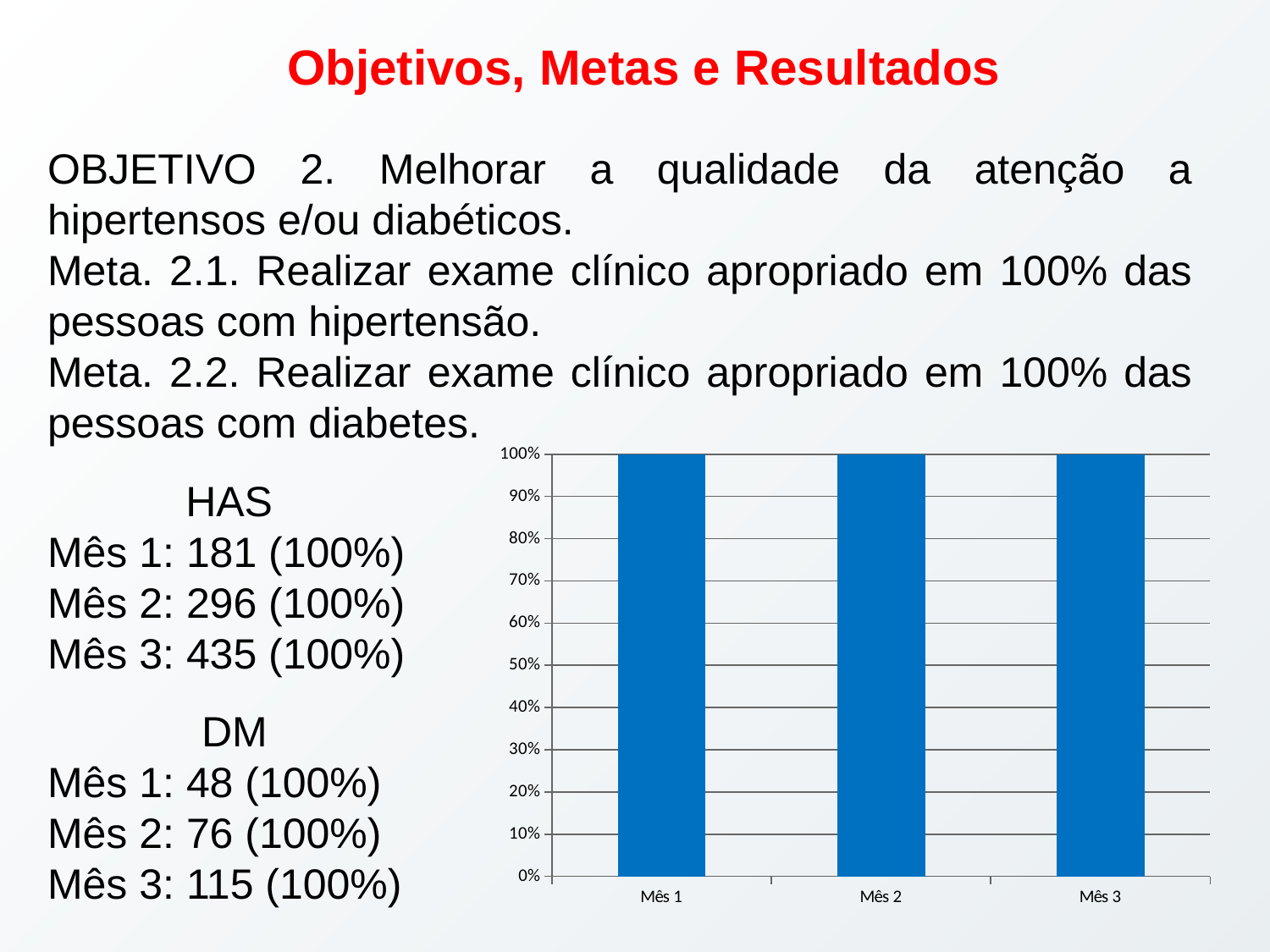
What are the category labels on the x axis of the chart? Mês 1, Mês 2, Mês 3 What value does the bar for Mês 3 reach in the chart? 100% Is the value for Mês 2 greater or less than 50%? greater Do the bar values rise, fall or stay the same from Mês 1 to Mês 3? stay the same Is the value for Mês 3 greater or less than 90%? greater What is the highest value shown on the chart's y axis? 100% What value does the bar for Mês 2 reach in the chart? 100% What is the difference between the values for Mês 1 and Mês 3? 0% What kind of chart is shown on the slide? bar chart What value does the bar for Mês 1 reach in the chart? 100% How many bars are plotted in the chart? 3